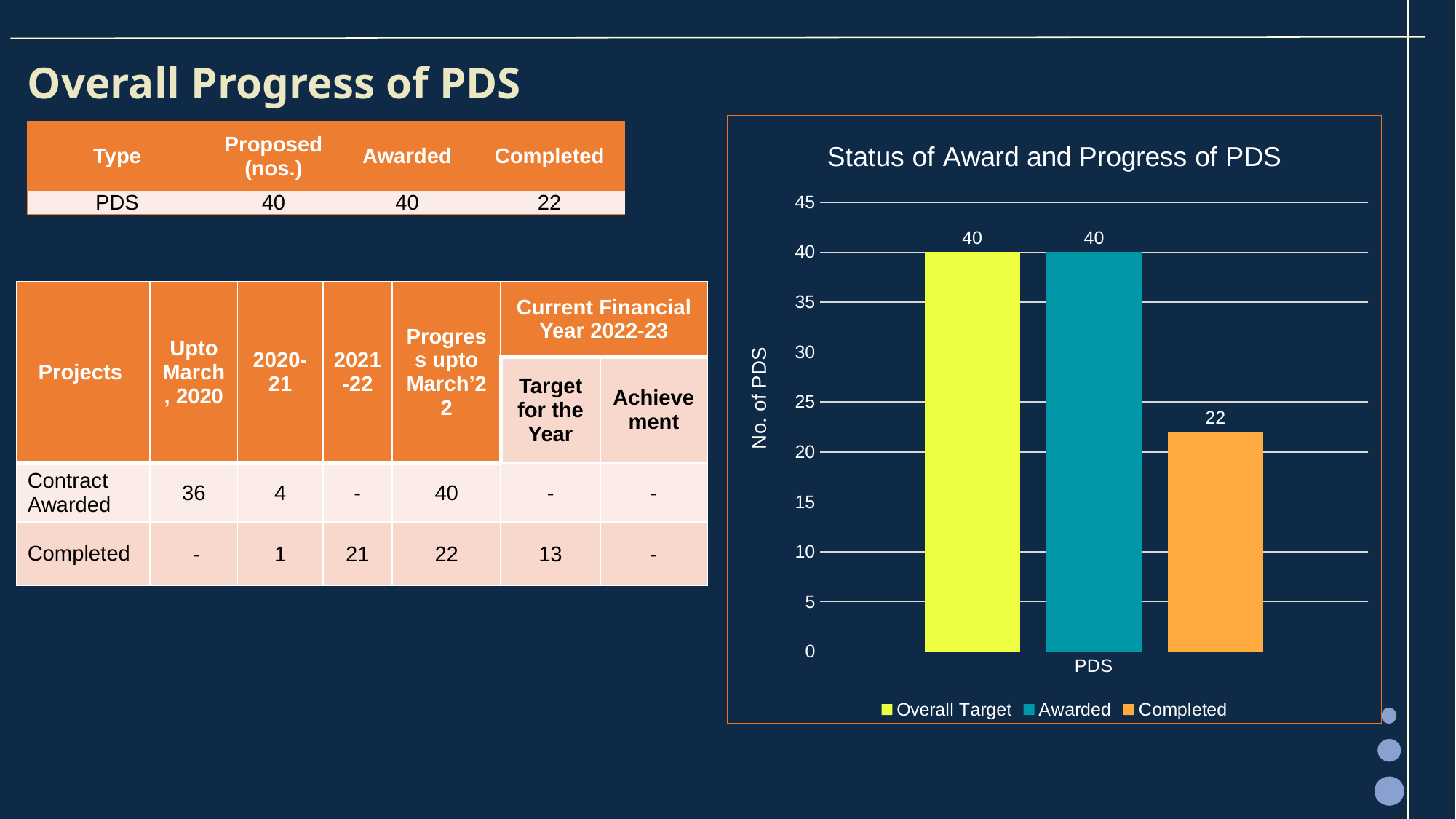
What is the value of the Awarded series for PDS in the chart? 40 What is the label of the y axis of the chart? No. of PDS What is the title of the chart? Status of Award and Progress of PDS How many categories are shown on the x axis of the chart? 1 Which is larger for PDS, the Overall Target value or the Completed value? Overall Target Is the Completed value for PDS greater or less than 25? less What is the value of the Overall Target series for PDS in the chart? 40 How many series does the chart legend list? 3 Which series has the lowest value in the chart? Completed What is the value of the Completed series for PDS in the chart? 22 What kind of chart is shown on the slide? bar chart What is the difference between the Awarded value and the Completed value for PDS? 18